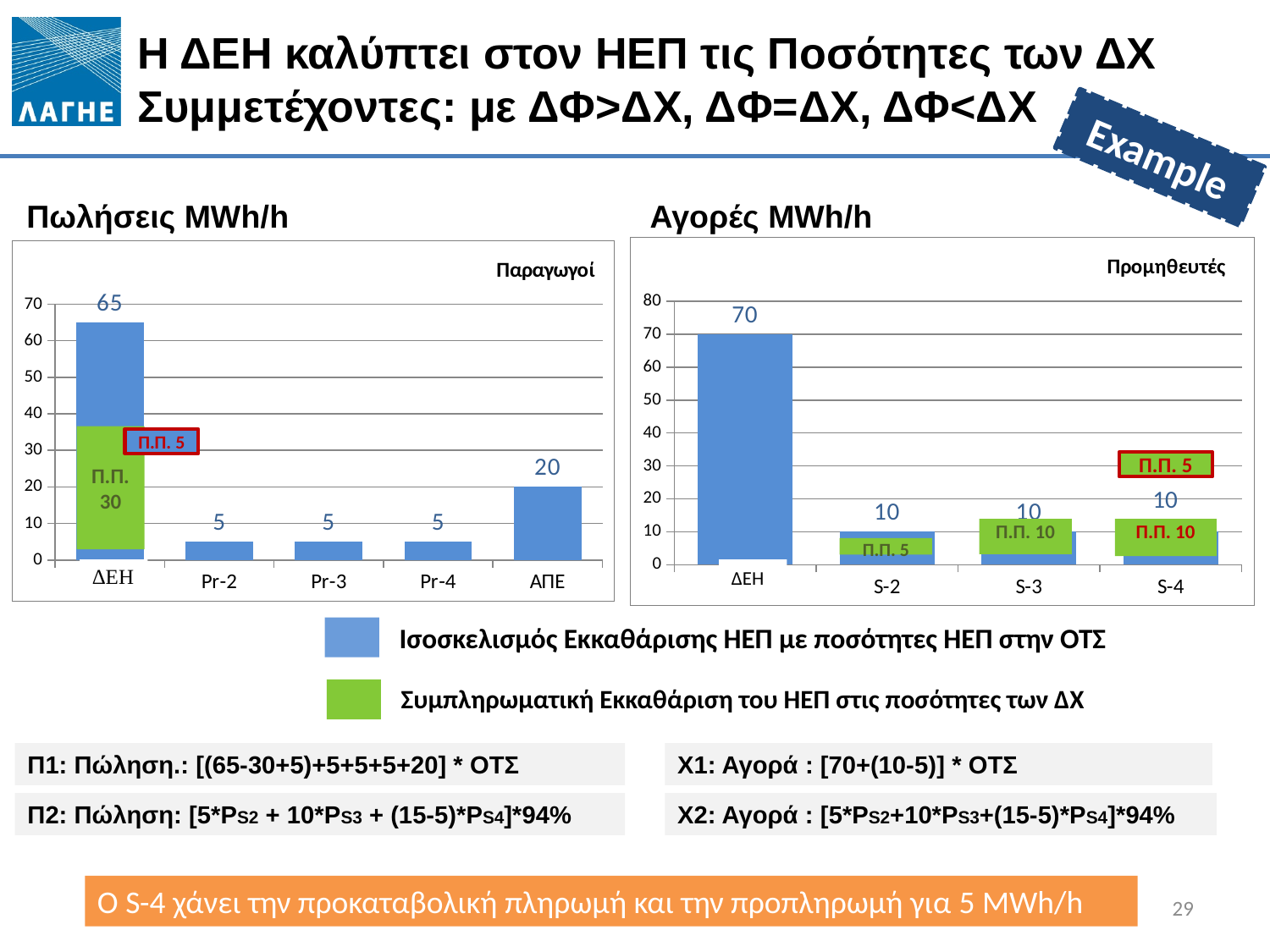
In the Πωλήσεις MWh/h chart on the left, what is the difference between the values for ΔΕΗ and ΑΠΕ? 45 In the Πωλήσεις MWh/h chart on the left, what is the value labelled for Pr-3? 5 What kind of chart is the Πωλήσεις MWh/h chart on the left? Bar chart In the Αγορές MWh/h chart on the right, what is the value labelled for ΔΕΗ? 70 In the Πωλήσεις MWh/h chart on the left, which is larger, the value for ΑΠΕ or the value for Pr-4? ΑΠΕ In the Πωλήσεις MWh/h chart on the left, which category has the highest value? ΔΕΗ In the Αγορές MWh/h chart on the right, which category has the highest value? ΔΕΗ In the Πωλήσεις MWh/h chart on the left, what is the value labelled for ΔΕΗ? 65 In the Αγορές MWh/h chart on the right, what is the value labelled for S-3? 10 How many categories are shown on the x axis of the Αγορές MWh/h chart on the right? 4 In the Αγορές MWh/h chart on the right, what is the difference between the values for ΔΕΗ and S-2? 60 In the Πωλήσεις MWh/h chart on the left, what is the value labelled for ΑΠΕ? 20